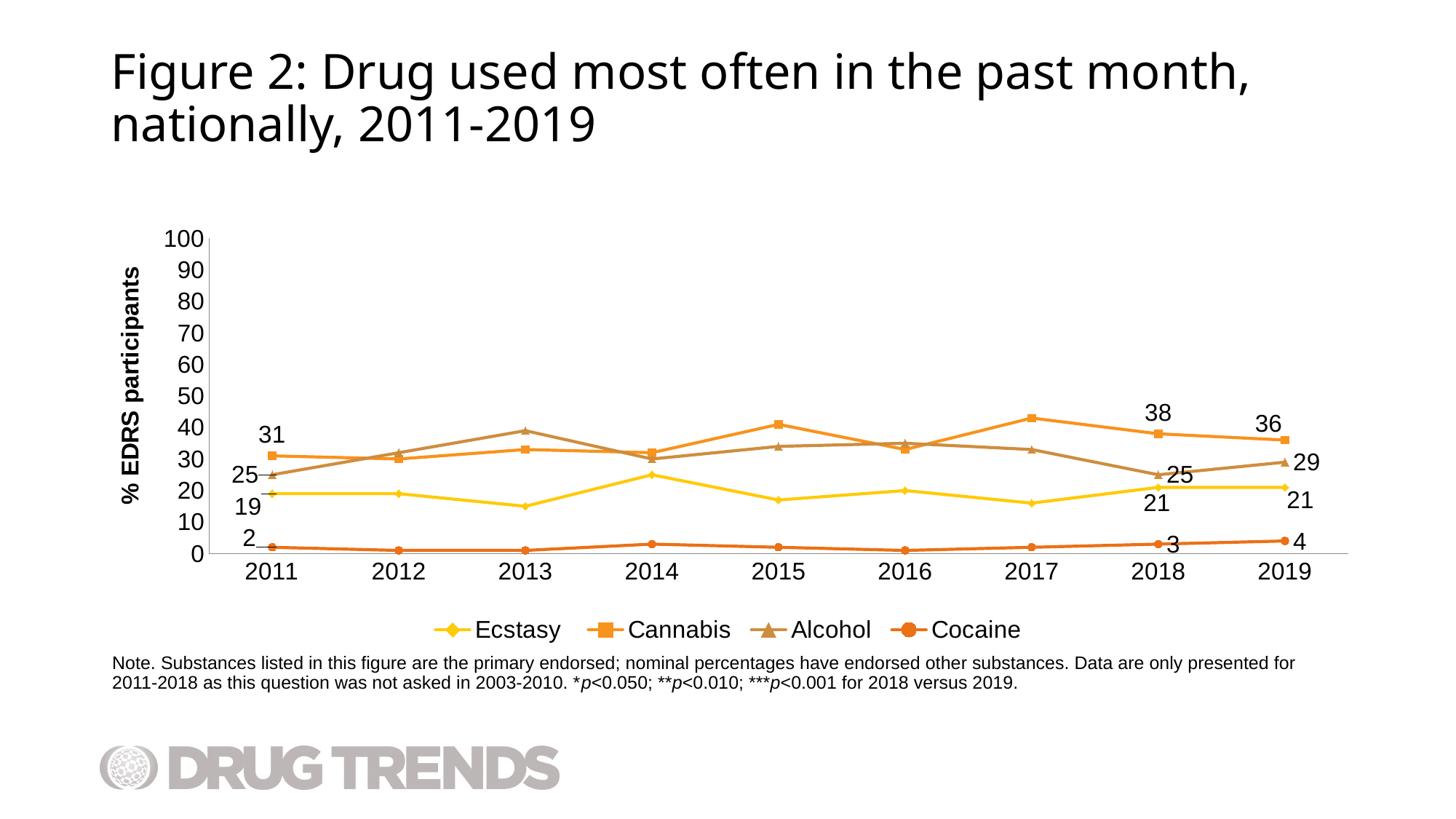
Which drug has the lowest value in 2011? Cocaine What is the value for Alcohol in 2019? 29 What type of chart is shown on the slide? line chart What is the value for Ecstasy in 2011? 19 How many years are plotted along the x axis? 9 What percentage of EDRS participants reported Cannabis as the drug used most often in 2018? 38 Which is larger in 2019, the value for Alcohol or the value for Ecstasy? Alcohol Is the value for Cannabis in 2017 greater or less than 40? greater What is the value for Cocaine in 2019? 4 What is the difference between the Cannabis values in 2018 and 2019? 2 How many series does the legend list? 4 Which drug has the highest value in 2019? Cannabis